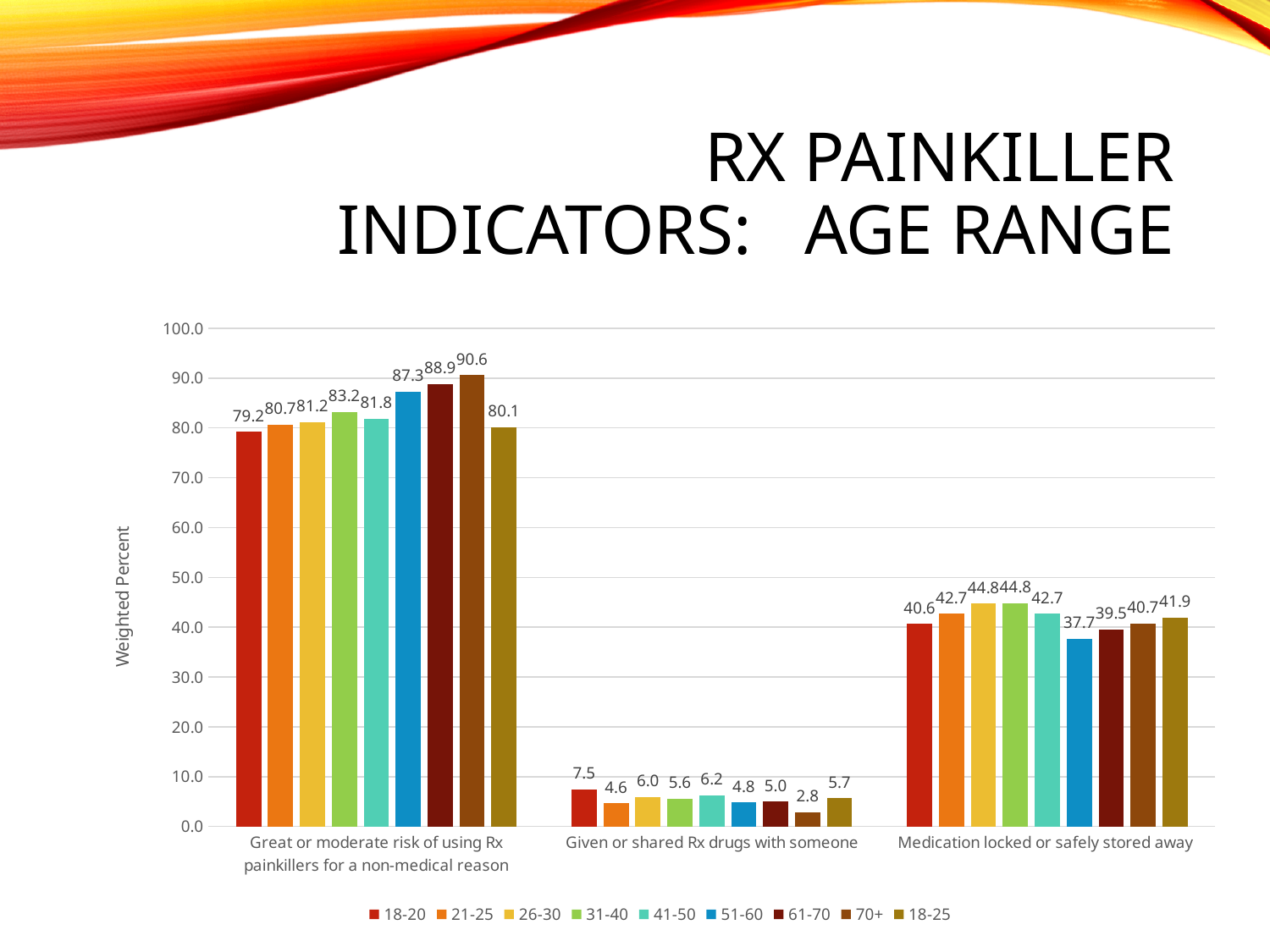
How many series does the legend list? 9 What is the label of the y axis? Weighted Percent What is the difference between the 70+ and 18-20 values for 'Great or moderate risk of using Rx painkillers for a non-medical reason'? 11.4 What is the value for the 51-60 age group for 'Medication locked or safely stored away'? 37.7 Which age group has the lowest value for 'Medication locked or safely stored away'? 51-60 Which age group has the lowest value for 'Given or shared Rx drugs with someone'? 70+ Which age group has the highest value for 'Great or moderate risk of using Rx painkillers for a non-medical reason'? 70+ What is the value for the 70+ age group for 'Great or moderate risk of using Rx painkillers for a non-medical reason'? 90.6 What is the value for the 18-20 age group for 'Given or shared Rx drugs with someone'? 7.5 What type of chart is shown on the slide? bar chart How many categories are shown on the x axis? 3 For 'Medication locked or safely stored away', which is larger: the value for 26-30 or the value for 61-70? 26-30